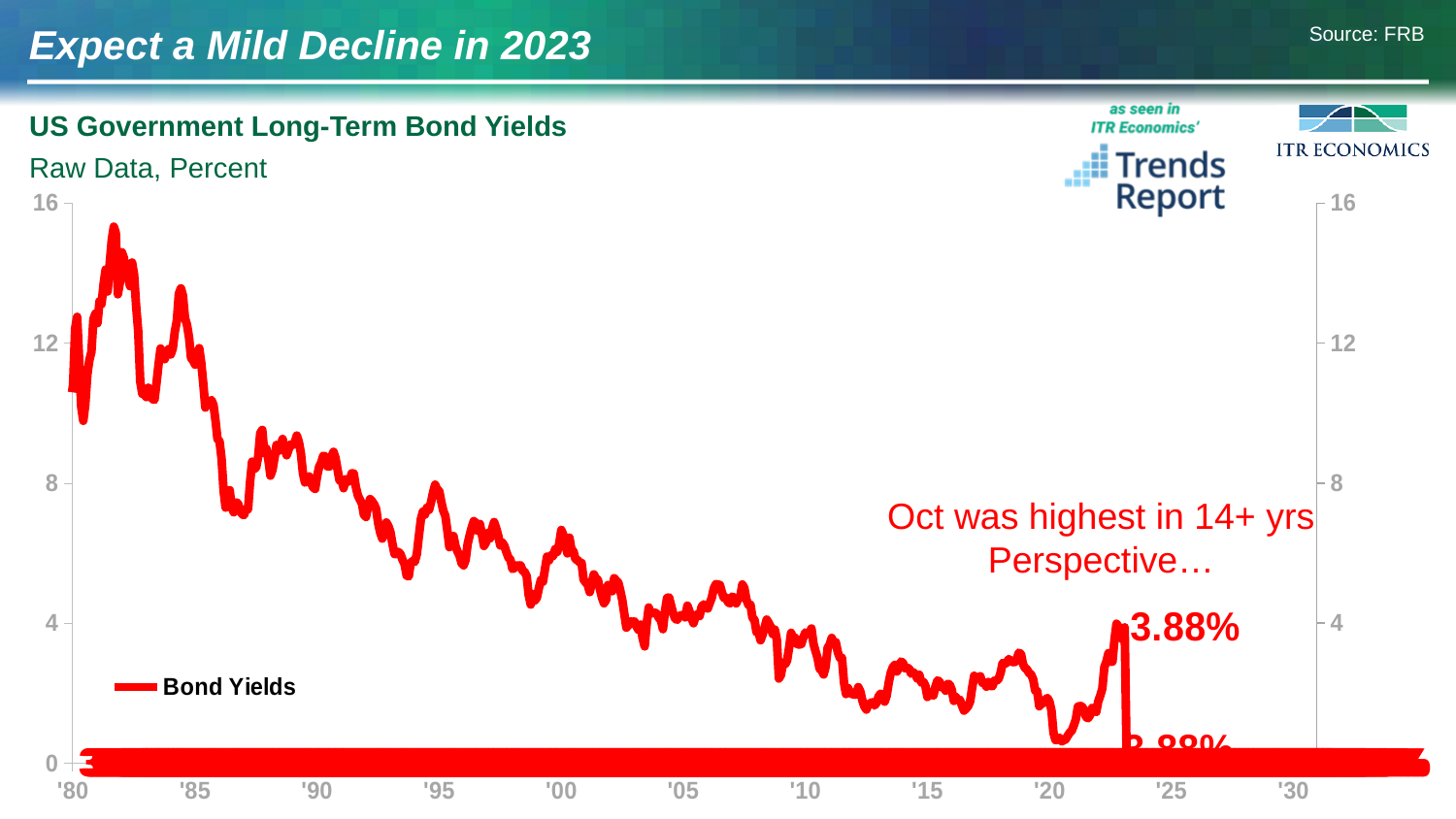
What is the name of the series shown in the legend? Bond Yields Is the value for Bond Yields at '10 larger or smaller than the value at '90? Smaller Overall, do bond yields rise or fall from '80 to '20 along the x axis? Fall What is the title of the chart? US Government Long-Term Bond Yields How many series does the chart's legend list? 1 Is the value for Bond Yields at '15 greater or less than 4? less What value is printed as a data label near the end of the Bond Yields line? 3.88% Is the value for Bond Yields at '00 greater or less than 8? less Is the value for Bond Yields at '85 greater or less than 8? greater Between which two x-axis labels does the Bond Yields line reach its highest point? '80 and '85 What kind of chart is shown on the slide? Line chart What is the highest tick value shown on the y axis? 16